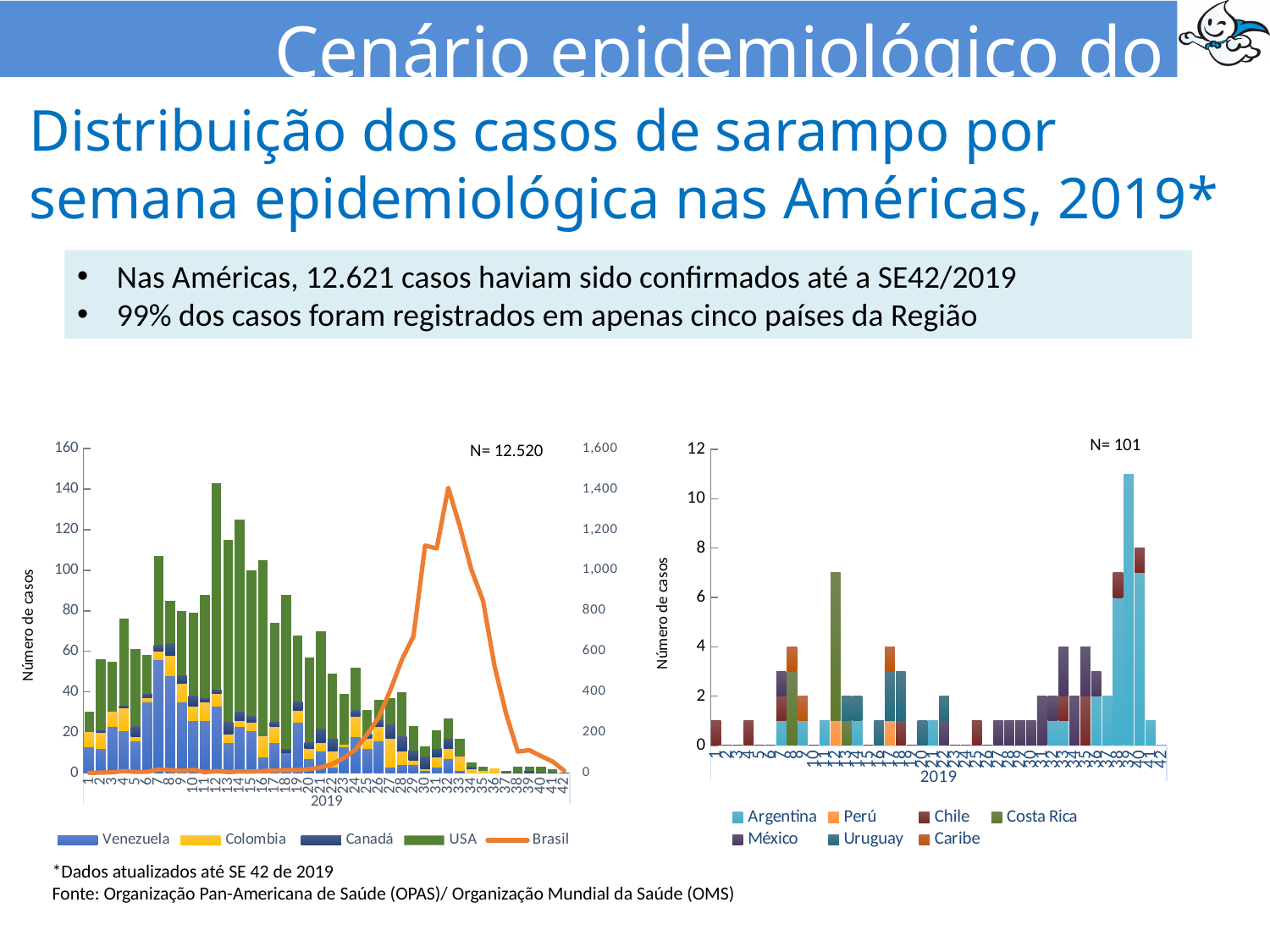
What kind of chart is the right chart on the slide? Stacked bar chart How many series does the legend of the right chart list? 7 In the left chart, is the peak of the Brasil line (week 32) greater or less than 1,200 on the right-hand axis? greater What kind of chart is the left chart on the slide? A stacked bar chart combined with a line In the left chart, does the Brasil line rise or fall from week 32 to week 42? fall In the right chart, which epidemiological week has the tallest stacked bar? 39 In the left chart, which series is plotted as a line rather than as bars? Brasil In the left chart, which epidemiological week has the tallest stacked bar? 12 In the right chart, is the stacked bar for week 39 greater or less than 10? greater What N value is printed on the right chart? N= 101 How many series does the legend of the left chart list? 5 In the left chart, is the stacked bar for week 12 greater or less than 120? greater